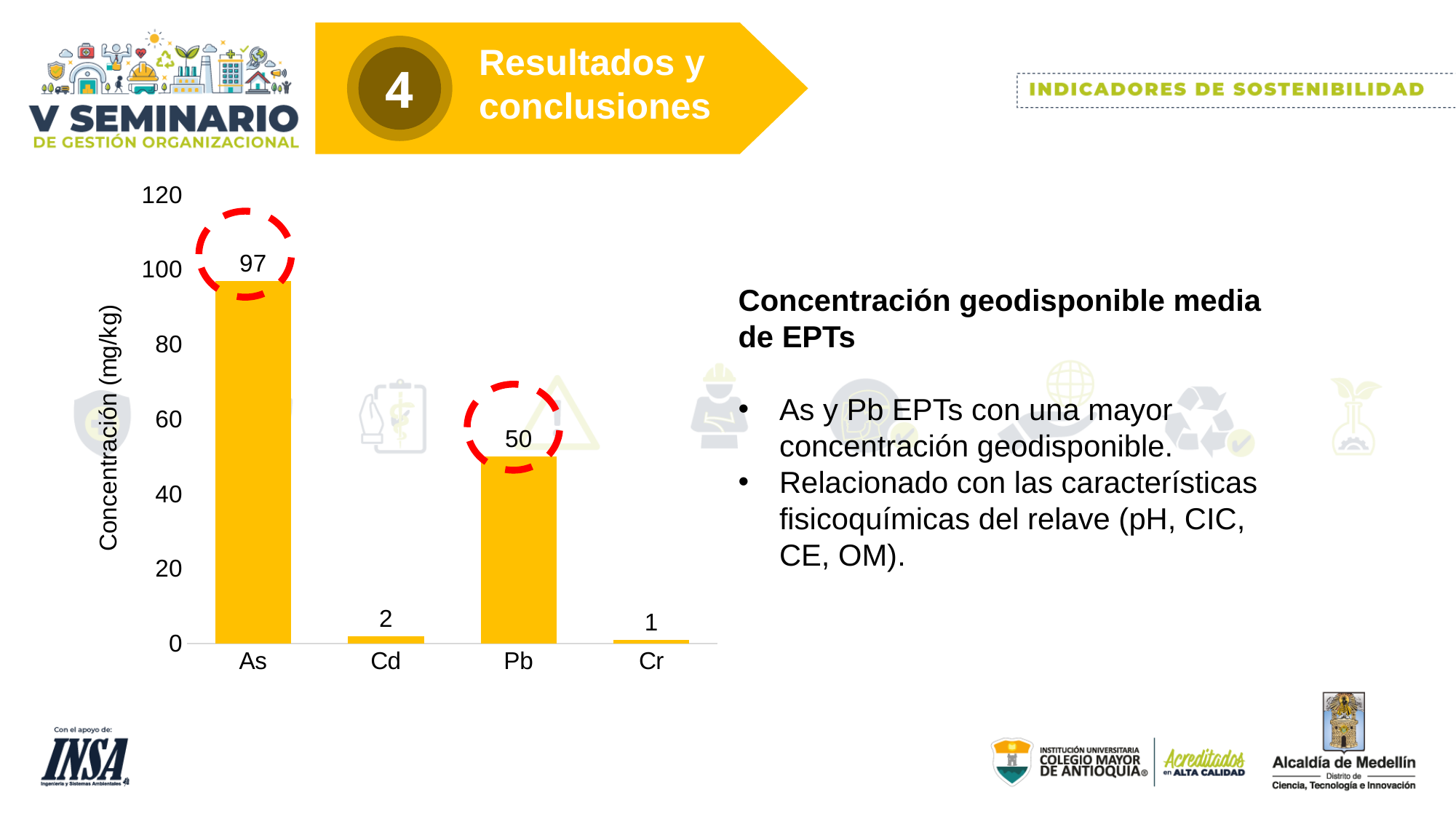
What is the concentration value shown for Pb? 50 What is the concentration value shown for Cr? 1 What is the label of the vertical axis of the chart? Concentración (mg/kg) Which element has the lowest concentration in the chart? Cr What is the difference between the concentration values for As and Pb? 47 Which has a larger concentration value, Cd or Pb? Pb What kind of chart is shown on the slide? Bar chart What is the concentration value shown for Cd? 2 Which element has the highest concentration in the chart? As How many elements (categories) are shown on the x axis of the chart? 4 What is the concentration value shown for As? 97 Is the value for As greater or less than 80? greater